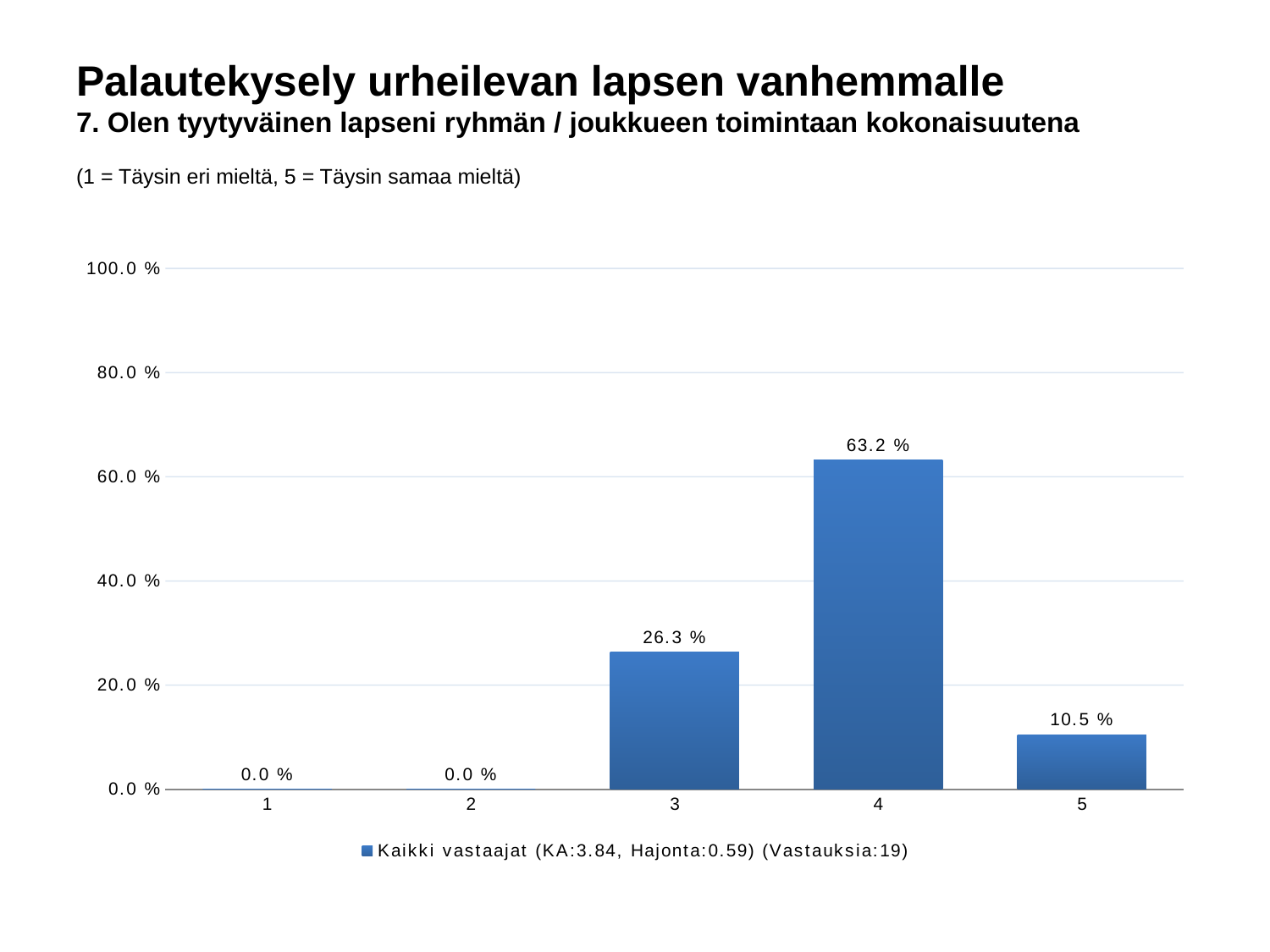
Is the value for category 4 greater or less than 60.0 %? greater What is the difference between the values for categories 4 and 3? 36.9 % How many categories are shown on the x axis? 5 What is the value for category 1? 0.0 % How many series does the legend list? 1 What kind of chart is shown on the slide? bar chart What is the value for category 4? 63.2 % According to the legend, how many responses (Vastauksia) does the series include? 19 Which category has the highest value? 4 What is the value for category 3? 26.3 % What is the value for category 5? 10.5 % Which is larger, the value for category 3 or the value for category 5? 3